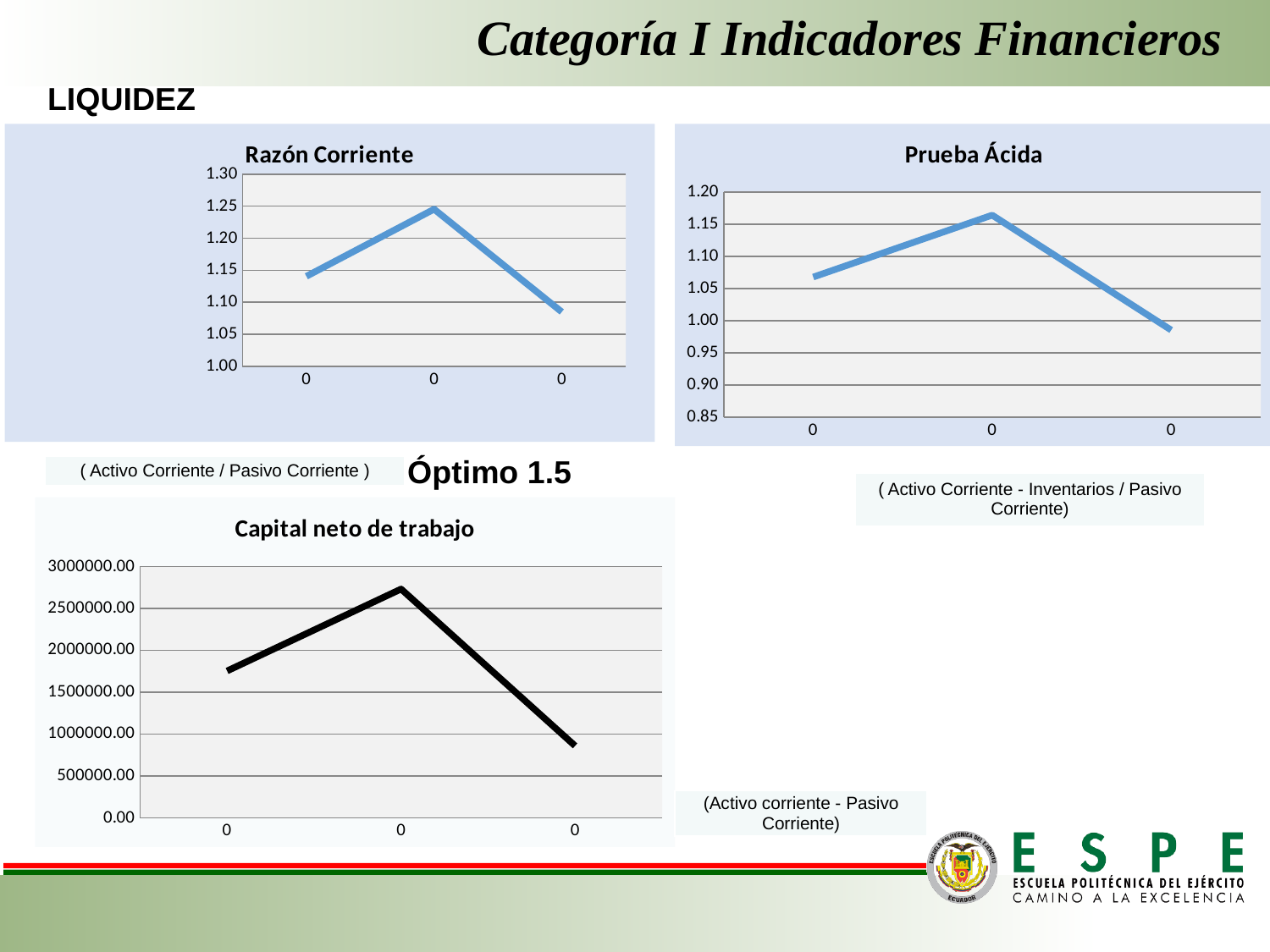
In the "Prueba Ácida" chart, which point is the lowest: the first, the middle or the last? The last point What kind of chart is the "Razón Corriente" chart? Line chart What colour is the line in the "Capital neto de trabajo" chart? Black In the "Razón Corriente" chart, is the value of the middle point greater or less than 1.20? greater In the "Prueba Ácida" chart, which is larger: the first point or the last point? The first point In the "Capital neto de trabajo" chart, do the values rise or fall from the middle point to the last point? Fall What is the title of the chart in the bottom-left of the slide? Capital neto de trabajo In the "Capital neto de trabajo" chart, is the value of the middle point greater or less than 2500000.00? greater In the "Razón Corriente" chart, which point is the highest: the first, the middle or the last? The middle point How many data points are plotted in the "Prueba Ácida" chart? 3 In the "Capital neto de trabajo" chart, is the value of the last point greater or less than 1000000.00? less